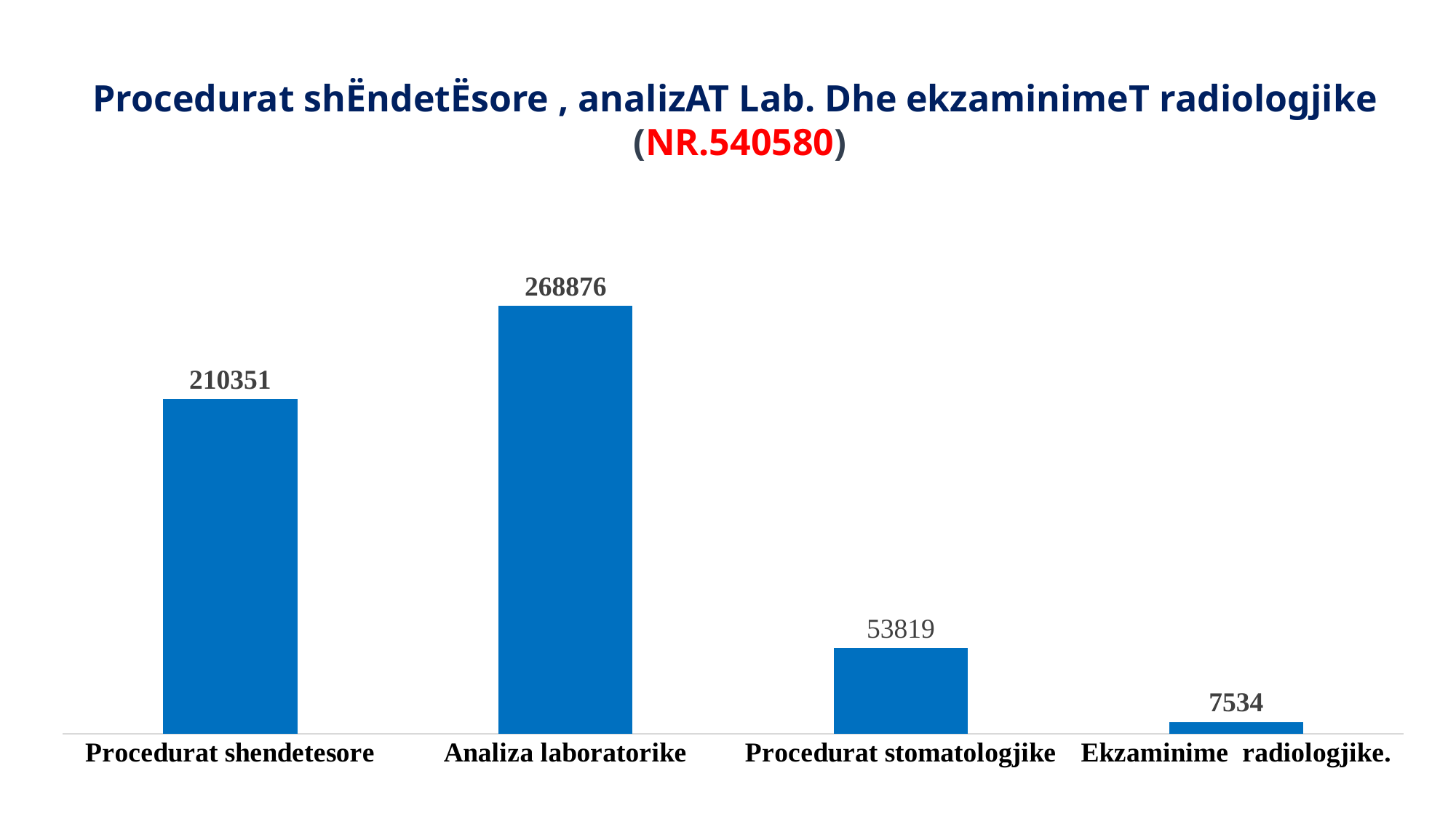
What is the value for Procedurat shendetesore? 210351 Which category has the lowest value? Ekzaminime radiologjike Which is larger, the value for Procedurat shendetesore or the value for Procedurat stomatologjike? Procedurat shendetesore What is the value for Analiza laboratorike? 268876 What total number is shown in red in the slide title? NR.540580 Which category has the highest value? Analiza laboratorike How many categories are shown in the chart? 4 What kind of chart is shown on the slide? Bar chart What is the value for Procedurat stomatologjike? 53819 What is the difference between the values for Procedurat stomatologjike and Ekzaminime radiologjike? 46285 What is the difference between the values for Analiza laboratorike and Procedurat shendetesore? 58525 What is the value for Ekzaminime radiologjike? 7534